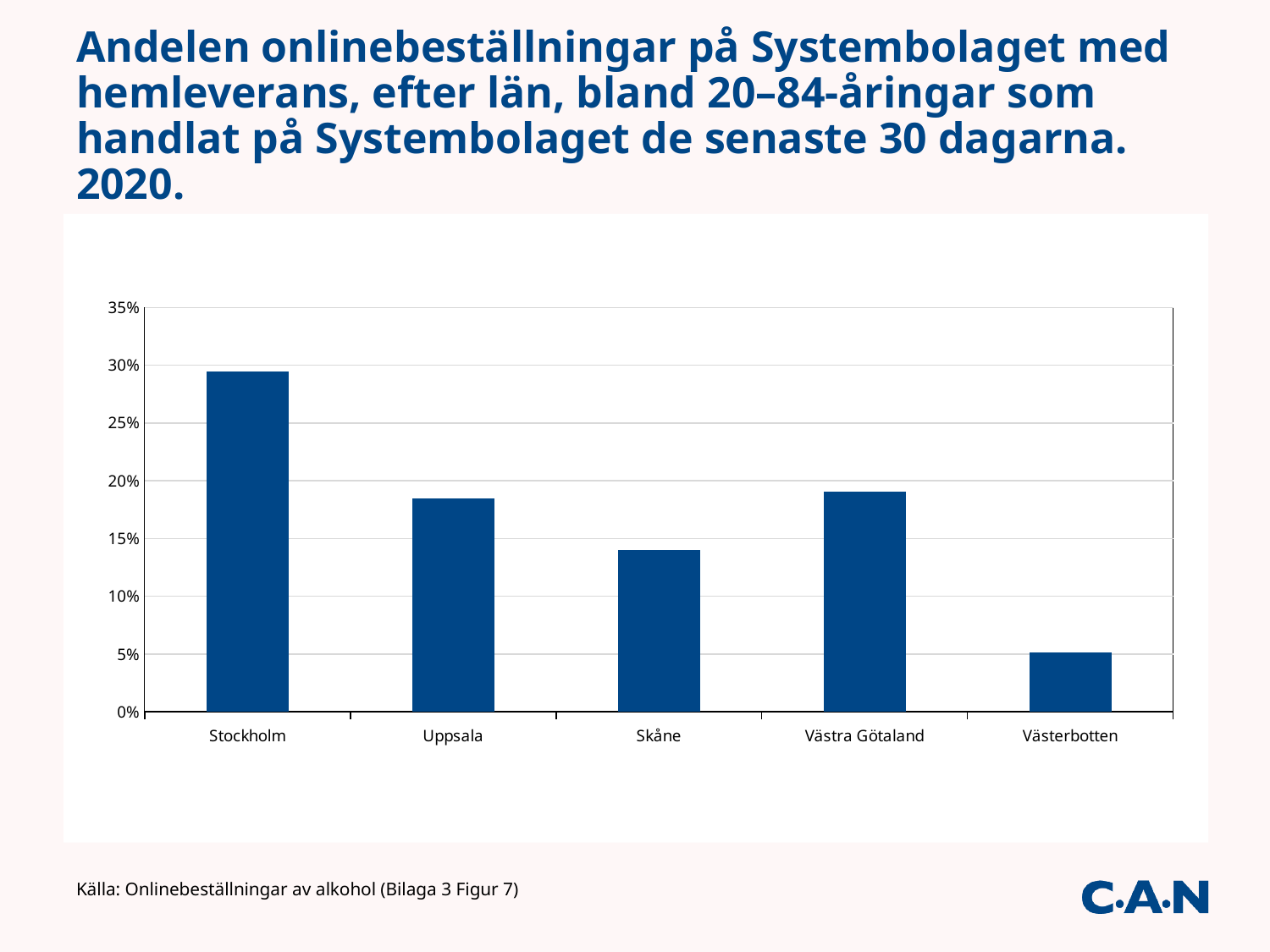
How many counties (län) are shown on the x axis of the chart? 5 What kind of chart is shown on the slide? bar chart Which is larger, the value for Skåne or the value for Västerbotten? Skåne Which county has the lowest share of online orders with home delivery? Västerbotten Which county has the highest share of online orders with home delivery? Stockholm Is the value for Stockholm greater or less than 25%? greater Is the value for Västra Götaland greater or less than 15%? greater What is the highest value shown on the y axis of the chart? 35% Is the value for Västerbotten greater or less than 10%? less Which is larger, the value for Uppsala or the value for Skåne? Uppsala